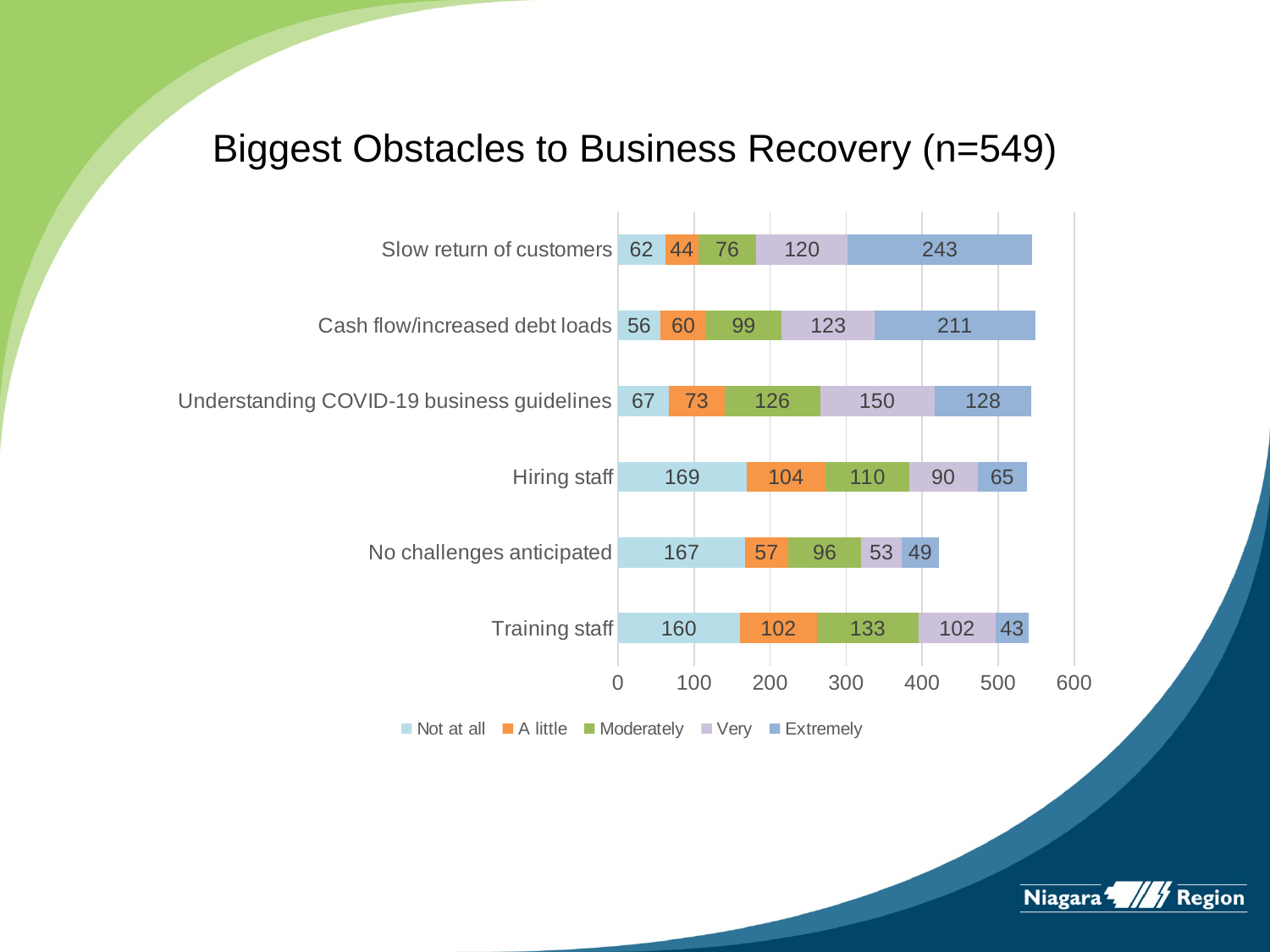
What kind of chart is shown on the slide? Stacked bar chart What is the total of the stacked bar for No challenges anticipated? 422 Which category has the lowest 'Extremely' value? Training staff Which is larger: the 'Very' value for Hiring staff or the 'Very' value for Training staff? Training staff How many categories are shown on the chart? 6 What is the title of the chart? Biggest Obstacles to Business Recovery (n=549) What is the 'Extremely' value for Slow return of customers? 243 What is the 'Moderately' value for Understanding COVID-19 business guidelines? 126 How many series does the legend list? 5 What is the difference between the 'Extremely' values for Slow return of customers and Cash flow/increased debt loads? 32 Which category has the highest 'Extremely' value? Slow return of customers What is the 'Not at all' value for Hiring staff? 169